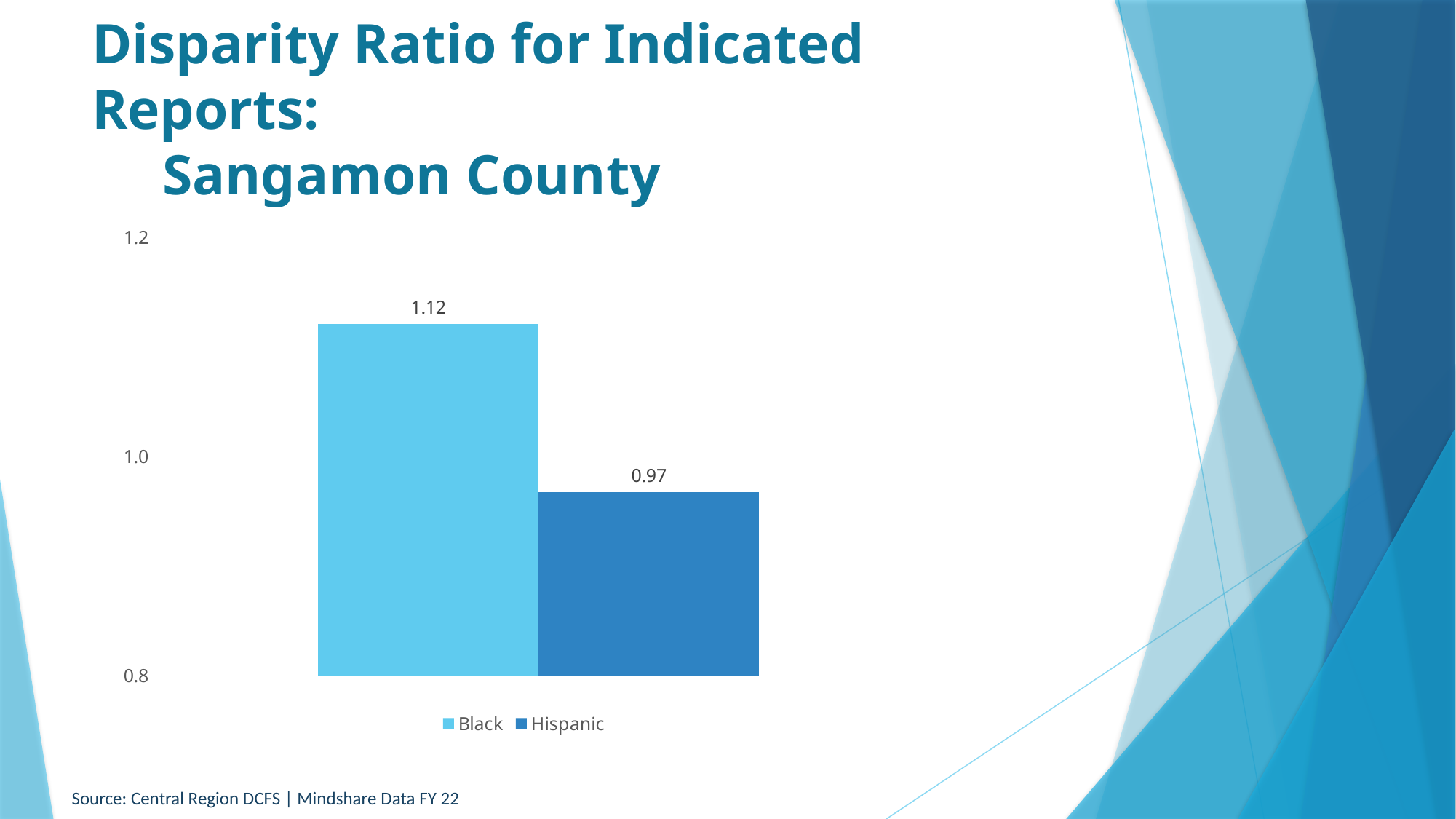
What is the maximum value shown on the vertical axis? 1.2 What is the disparity ratio for Black? 1.12 What is the difference between the Black and Hispanic disparity ratios? 0.15 Which group has the lower disparity ratio? Hispanic What kind of chart is shown on the slide? Bar chart How many series does the legend list? 2 Which group has the higher disparity ratio? Black What is the disparity ratio for Hispanic? 0.97 How many bars are plotted in the chart? 2 Is the disparity ratio for Black greater or less than 1.0? greater Is the disparity ratio for Hispanic greater or less than 1.0? less What is the source cited for the chart data? Central Region DCFS | Mindshare Data FY 22